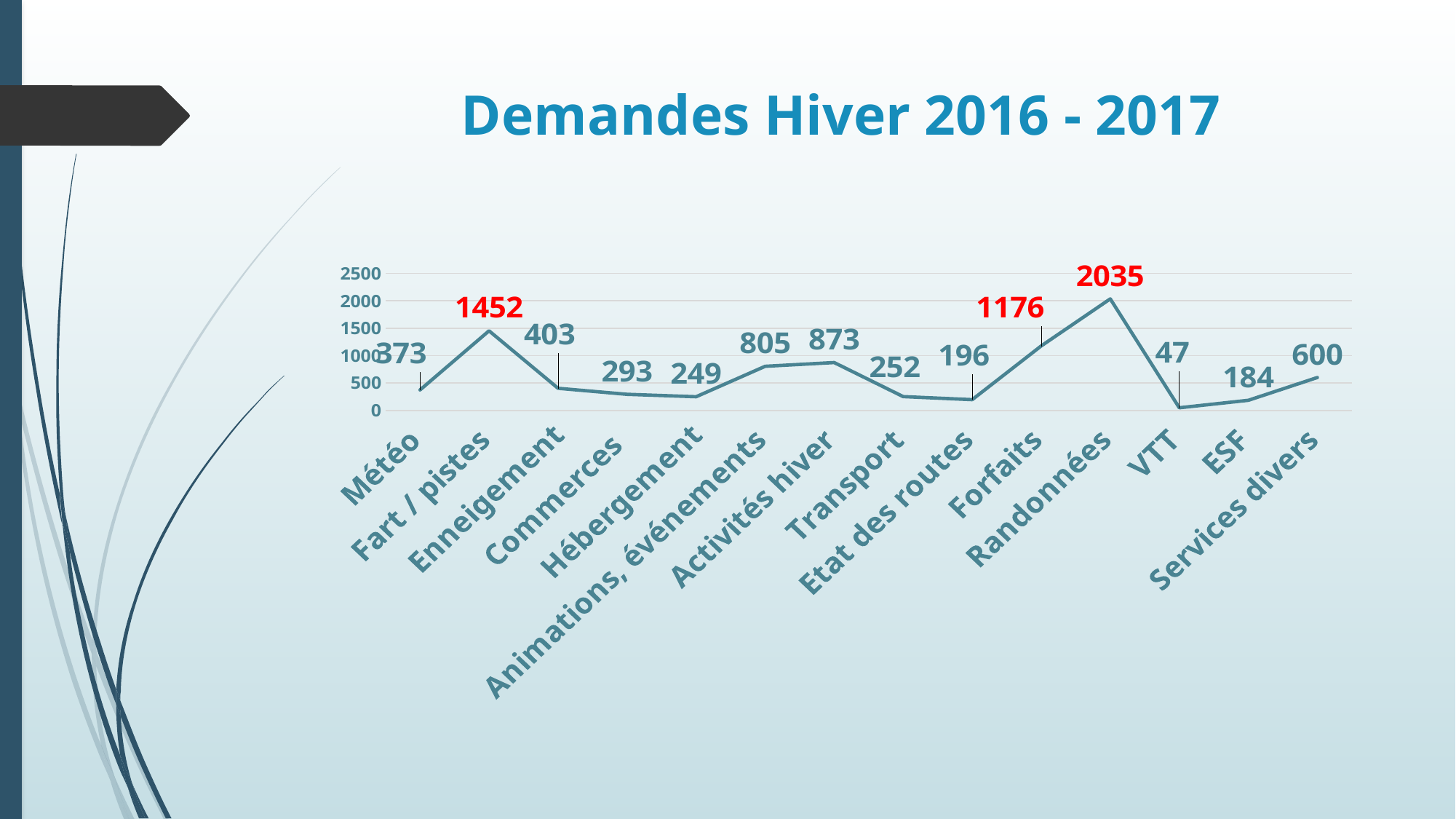
Which is larger, the value for Animations, événements or the value for Services divers? Animations, événements What kind of chart is shown on the slide? line chart What is the value for Randonnées? 2035 Which category has the lowest value? VTT What is the title of the chart? Demandes Hiver 2016 - 2017 How many categories are plotted on the x axis? 14 What is the difference between the values for Randonnées and Forfaits? 859 What is the value for VTT? 47 Which category has the highest value? Randonnées What is the value for Activités hiver? 873 Is the value for Forfaits greater or less than 1000? greater What is the value for Fart / pistes? 1452